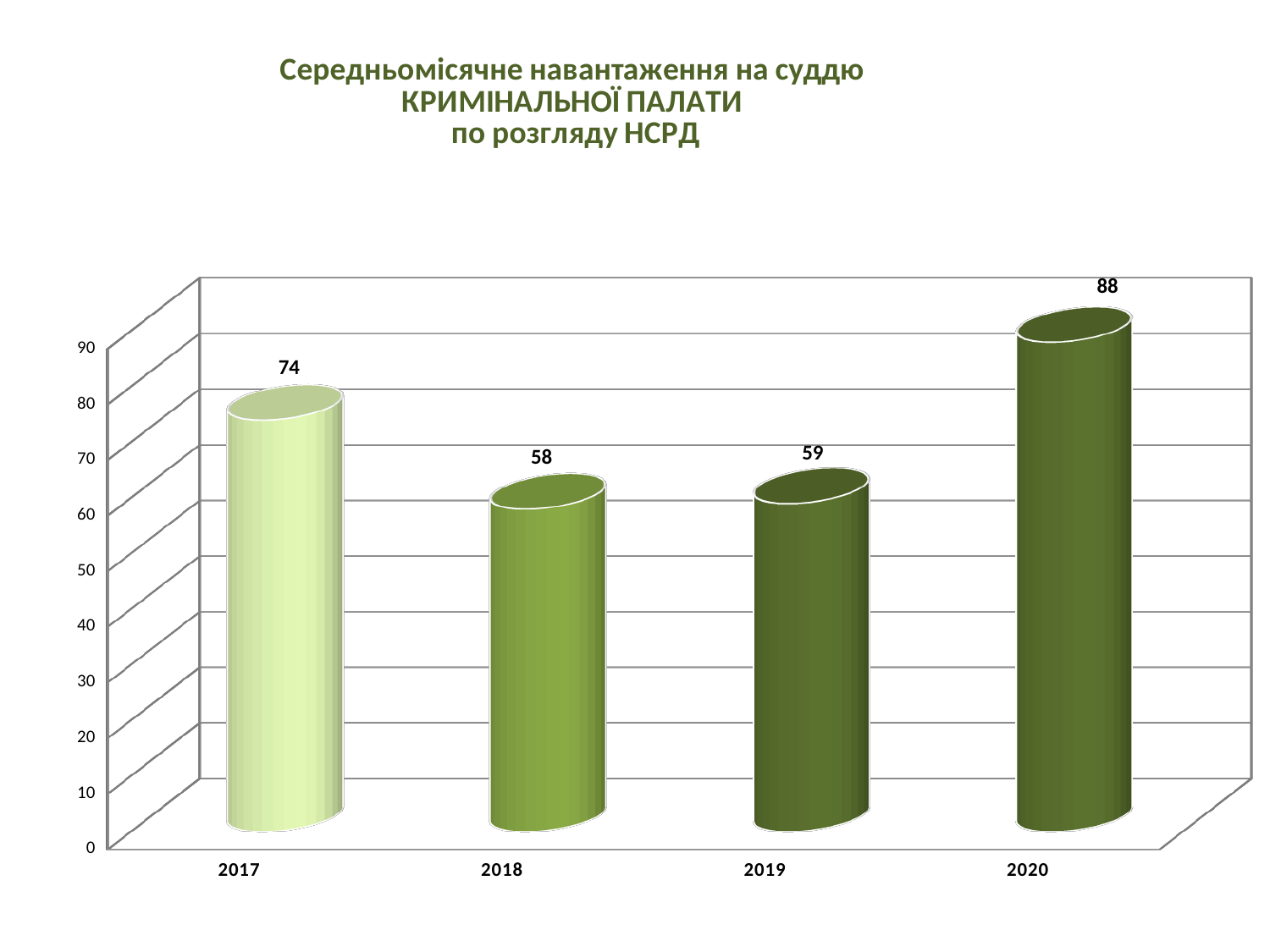
What is the difference between the values for 2019 and 2018? 1 Which year has the highest value? 2020 What is the value for 2018? 58 What is the value for 2017? 74 Does the value rise or fall from 2019 to 2020? rise What is the difference between the values for 2020 and 2017? 14 How many years are shown on the chart? 4 What kind of chart is shown on the slide? bar chart Which is larger, the value for 2017 or the value for 2019? 2017 What is the value for 2019? 59 Which year has the lowest value? 2018 What is the value for 2020? 88